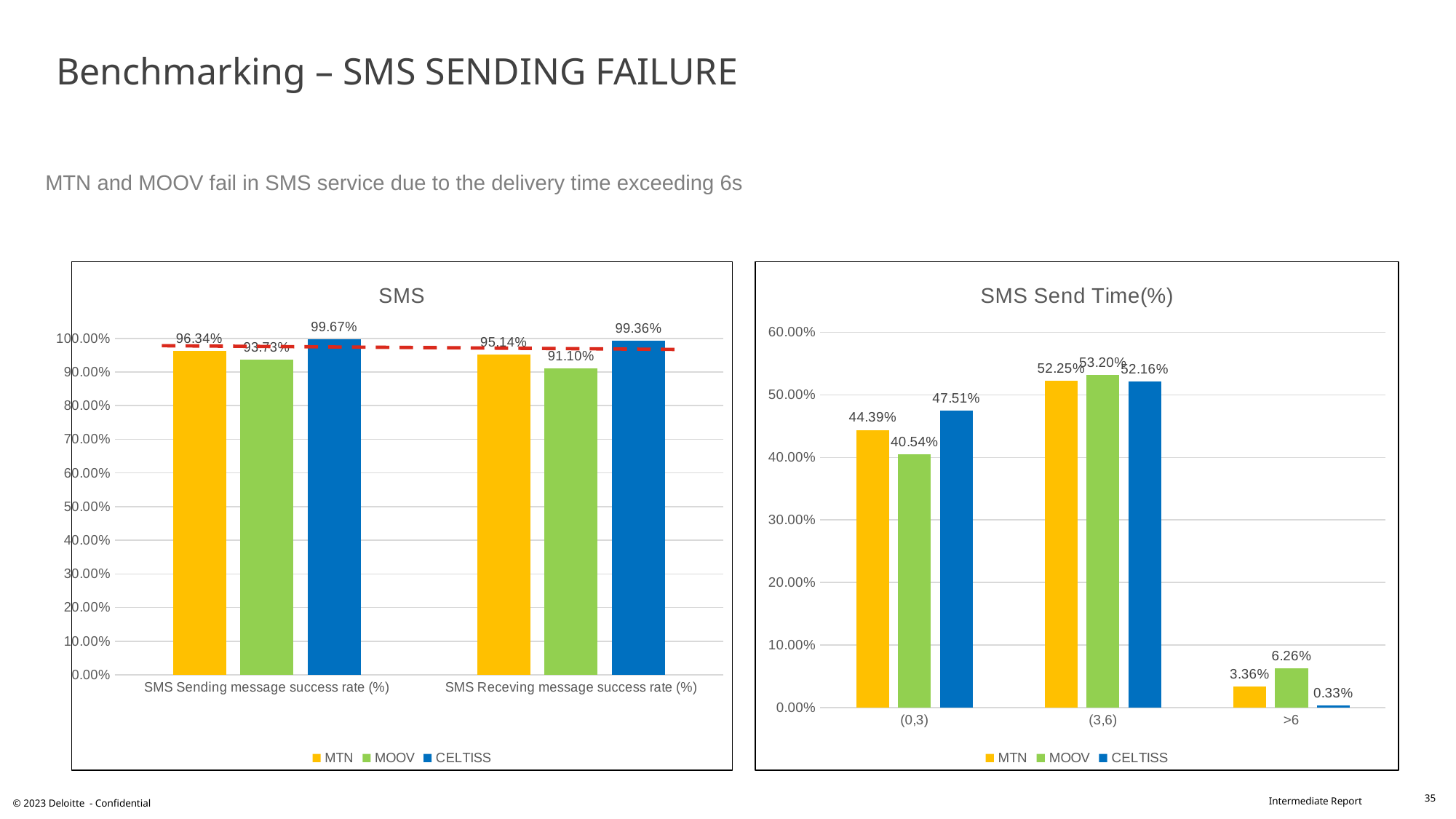
In the "SMS" chart, what is the SMS Sending message success rate (%) for CELTISS? 99.67% In the "SMS" chart, what is the SMS Receving message success rate (%) for MOOV? 91.10% In the "SMS Send Time(%)" chart, what is the difference between MOOV and MTN in the >6 category? 2.90% In the "SMS Send Time(%)" chart, which is larger in the >6 category: MTN or MOOV? MOOV In the "SMS" chart, what is the difference between the CELTISS and MTN SMS Receving message success rates (%)? 4.22% In the "SMS Send Time(%)" chart, what is the value for CELTISS in the >6 category? 0.33% In the "SMS Send Time(%)" chart, what is the value for MOOV in the (0,3) category? 40.54% In the "SMS" chart, which operator has the lowest SMS Sending message success rate (%)? MOOV In the "SMS" chart, how many series does the legend list? 3 What kind of chart is the "SMS Send Time(%)" chart? Bar chart In the "SMS Send Time(%)" chart, how many categories are shown on the x axis? 3 In the "SMS Send Time(%)" chart, which operator has the highest value in the (0,3) category? CELTISS